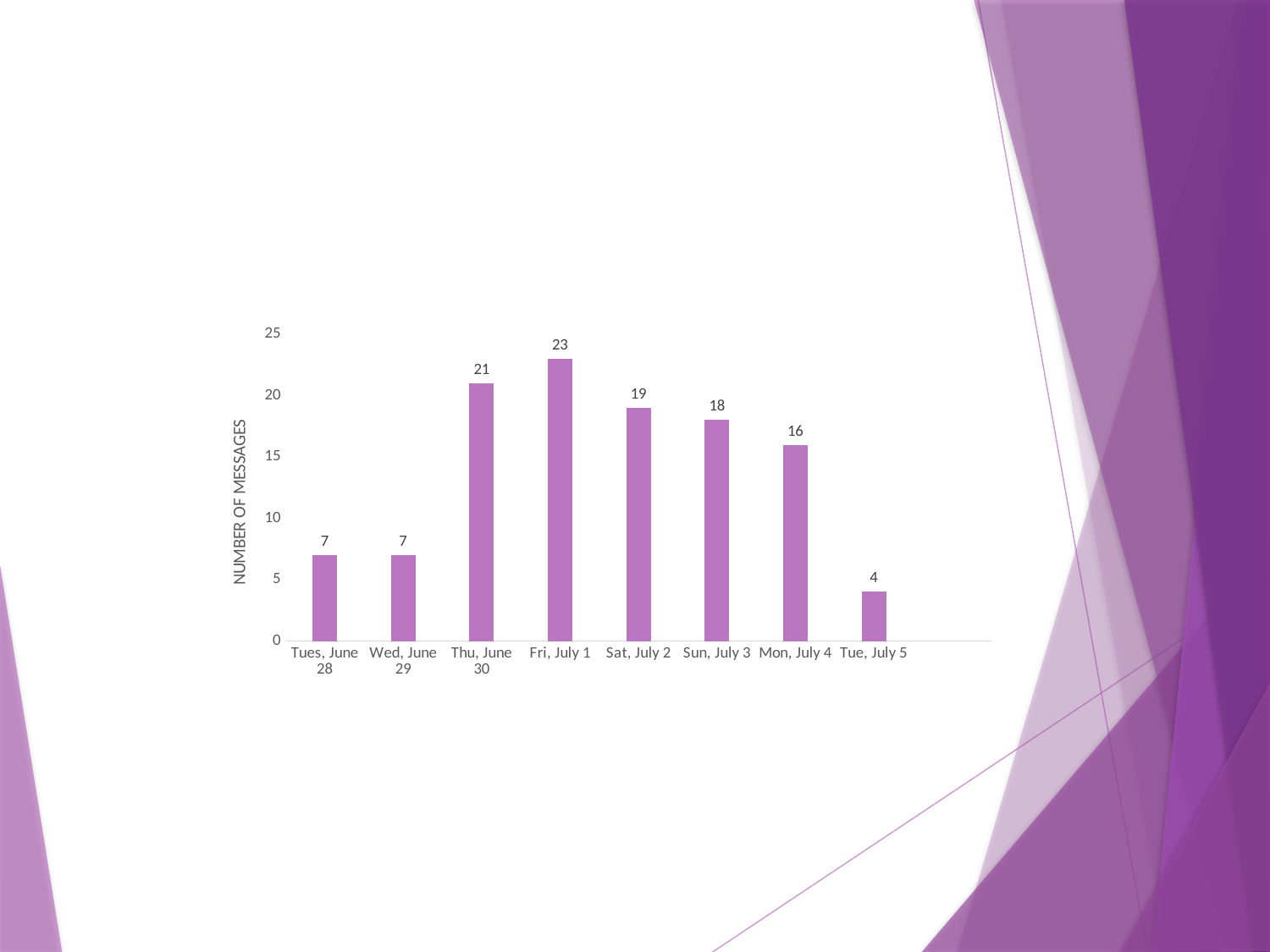
What is the difference in number of messages between Fri, July 1 and Tue, July 5? 19 What is the number of messages for Tue, July 5? 4 What is the difference in number of messages between Thu, June 30 and Wed, June 29? 14 What is the number of messages for Thu, June 30? 21 What is the label of the vertical axis? NUMBER OF MESSAGES How many messages were there on Fri, July 1? 23 Which day has the highest number of messages? Fri, July 1 Is the number of messages for Sun, July 3 greater or less than 15? greater Which has more messages, Sat, July 2 or Mon, July 4? Sat, July 2 What kind of chart is shown on the slide? bar chart Which day has the lowest number of messages? Tue, July 5 How many days are shown on the x axis of the chart? 8